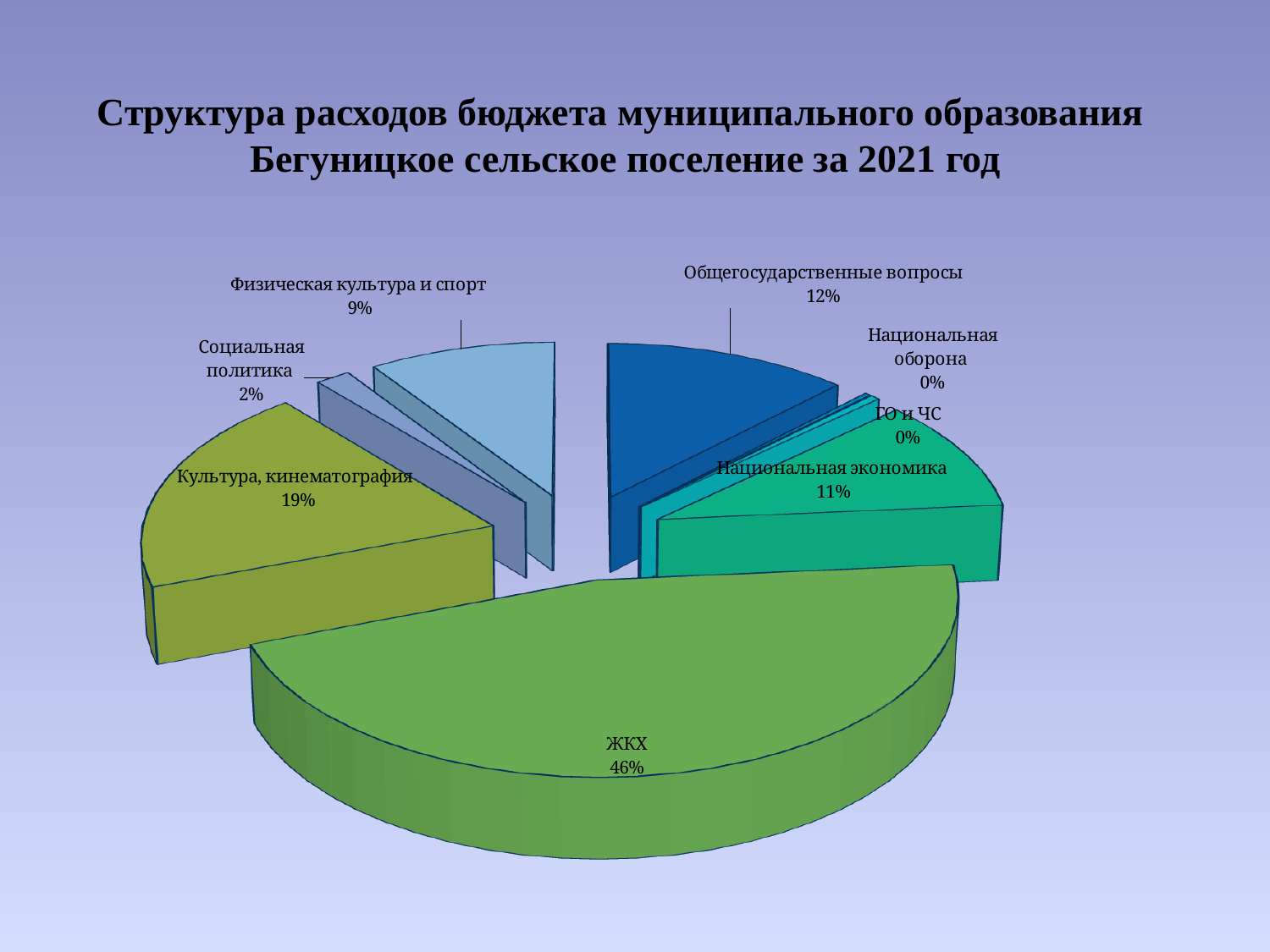
Which category has the largest share of the budget expenditure? ЖКХ What kind of chart is shown on the slide? Pie chart What share is shown for Культура, кинематография? 19% What share is shown for Национальная экономика? 11% What is the difference in percentage points between ЖКХ and Культура, кинематография? 27 percentage points What share is shown for Общегосударственные вопросы? 12% What share of the budget expenditure is ЖКХ? 46% What is the title of the chart on the slide? Структура расходов бюджета муниципального образования Бегуницкое сельское поселение за 2021 год What share is shown for Физическая культура и спорт? 9% Which is larger: the share for Общегосударственные вопросы or the share for Физическая культура и спорт? Общегосударственные вопросы How many categories are shown in the pie chart? 8 What share is shown for Социальная политика? 2%